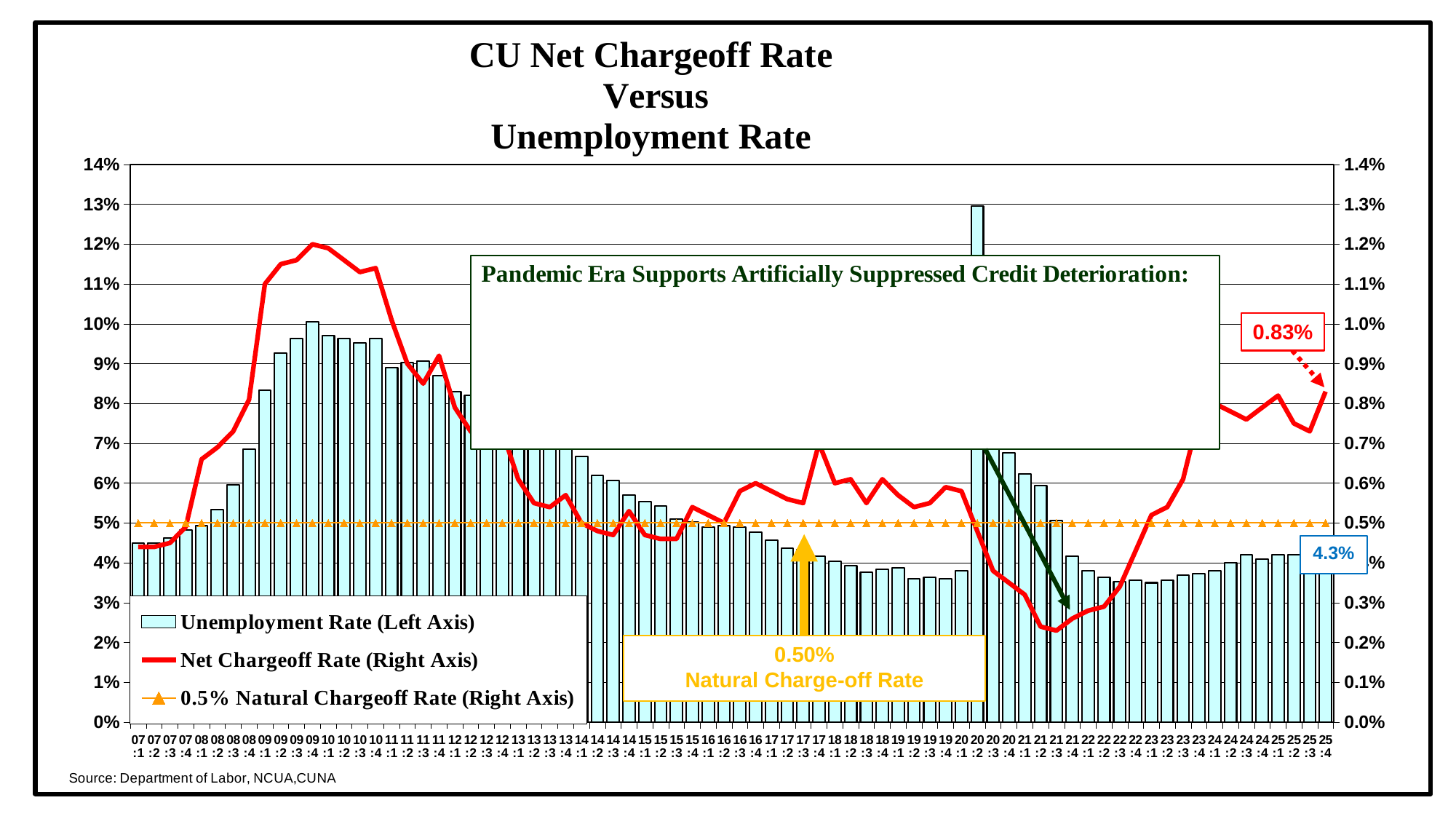
What kind of chart is shown on the slide? A combined bar and line chart Does the Net Chargeoff Rate rise or fall from 21:3 to 25:4? rise What is the Unemployment Rate labelled at the end of the series (25:4)? 4.3% Is the Net Chargeoff Rate for 09:4 greater or less than 1.1%? greater What is the Net Chargeoff Rate labelled at the end of the series (25:4)? 0.83% How many series does the legend list? 3 What is the title of the chart? CU Net Chargeoff Rate Versus Unemployment Rate Is the Net Chargeoff Rate for 21:3 greater or less than 0.3%? less Which is larger, the Unemployment Rate for 20:2 or for 09:4? 20:2 Is the Unemployment Rate for 20:2 greater or less than 12%? greater What value is given for the Natural Charge-off Rate? 0.50% In which quarter is the Unemployment Rate bar highest? 20:2